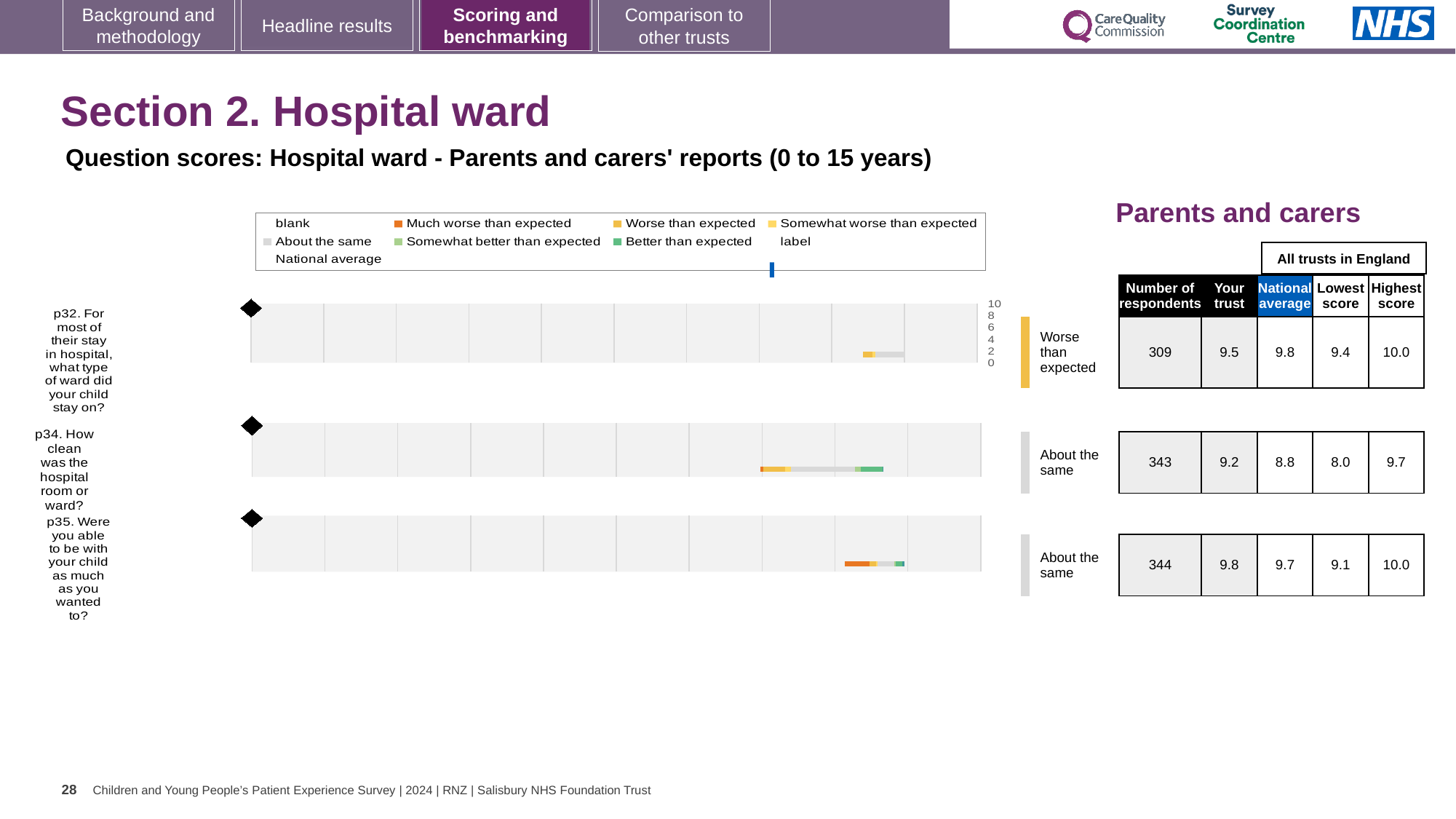
Which question has the lowest 'Your trust' score? p34 What benchmark category is shown for p32? Worse than expected What kind of chart is used to show the question scores on this slide? bar chart What is the highest score among all trusts in England for p34? 9.7 Which question has the highest 'Your trust' score? p35 What colour represents 'Much worse than expected' in the legend? Orange What is the 'Your trust' score for p34 (How clean was the hospital room or ward)? 9.2 What is the difference between the 'Your trust' score and the national average for p35? 0.1 What is the national average score for p32? 9.8 For p32, which is larger: the 'Your trust' score or the national average? National average How many respondents answered p35? 344 How many survey questions are plotted in the charts on this slide? 3